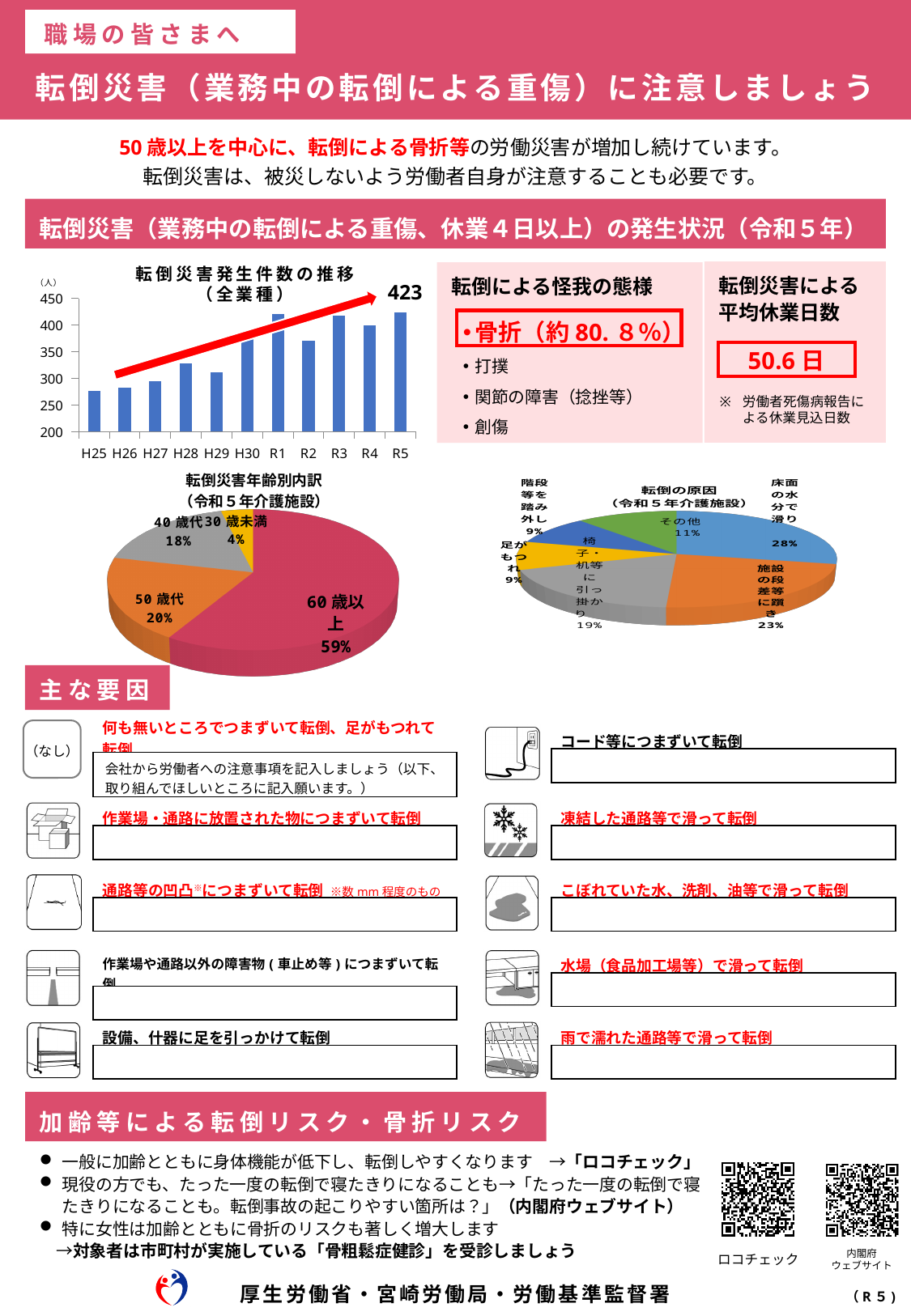
What kind of chart is 転倒災害発生件数の推移（全業種）? bar chart In the pie chart 転倒の原因（令和5年介護施設）, which cause has the largest share? 床面の水分で滑り In the pie chart 転倒の原因（令和5年介護施設）, what share does 施設の段差等に躓き have? 23% In the bar chart 転倒災害発生件数の推移（全業種）, do the values generally rise or fall from H25 to R5? rise In the bar chart 転倒災害発生件数の推移（全業種）, what is the value for R5? 423 In the bar chart 転倒災害発生件数の推移（全業種）, is the value for H25 greater or less than 300? less In the bar chart 転倒災害発生件数の推移（全業種）, which is larger, the value for H25 or the value for R5? R5 In the pie chart 転倒災害年齢別内訳（令和5年介護施設）, what share does 60歳以上 have? 59% In the pie chart 転倒災害年齢別内訳（令和5年介護施設）, what is the difference between the shares of 50歳代 and 40歳代? 2% In the pie chart 転倒災害年齢別内訳（令和5年介護施設）, which category has the smallest share? 30歳未満 In the bar chart 転倒災害発生件数の推移（全業種）, is the value for H30 greater or less than 350? greater How many categories are shown on the x axis of the bar chart 転倒災害発生件数の推移（全業種）? 11